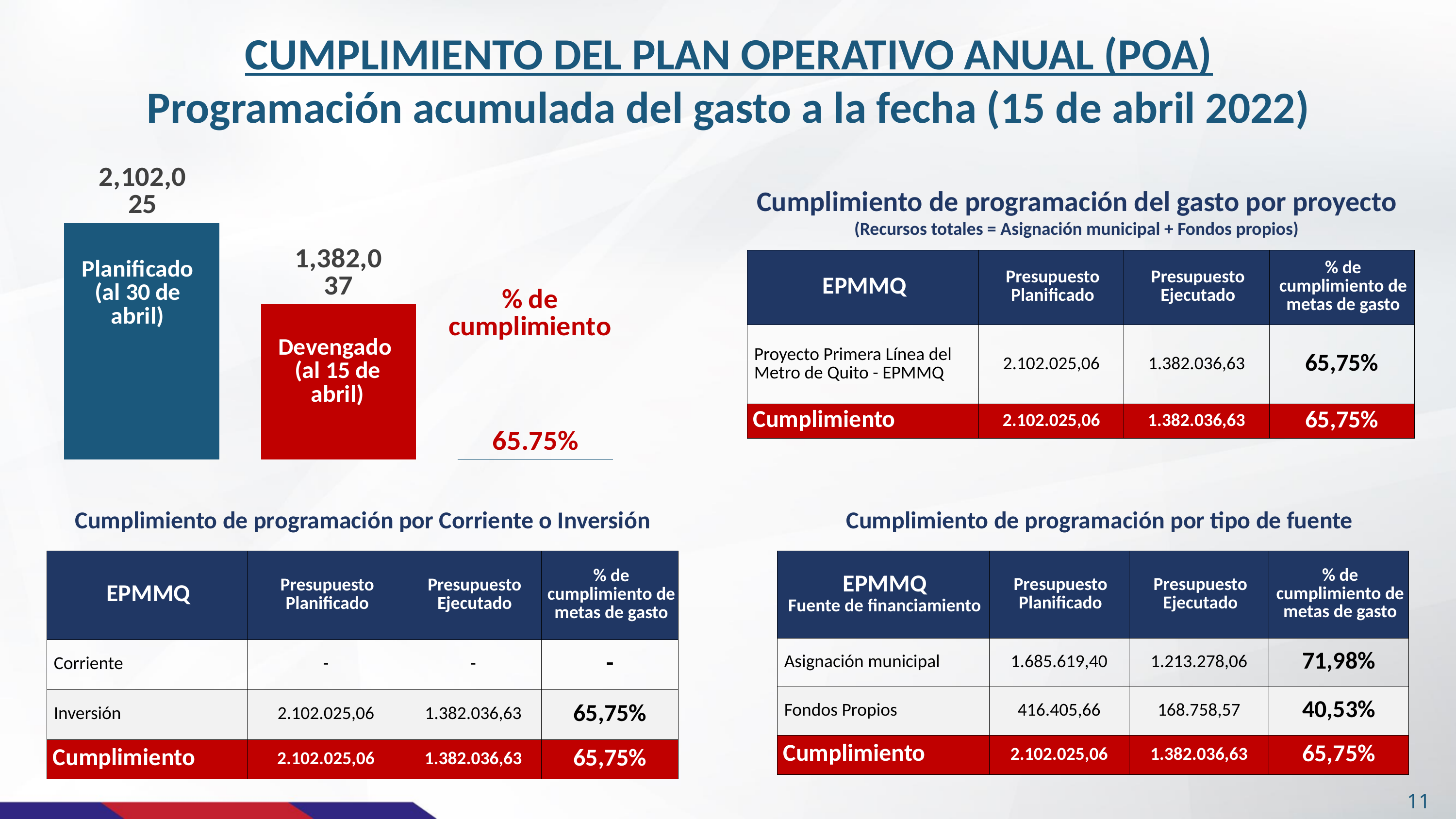
In the bar chart, do the values rise or fall from the left bar to the right bar? fall What kind of chart is shown on the left of the slide? bar chart How many bars are plotted in the bar chart? 2 In the bar chart, what value is shown for the 'Planificado (al 30 de abril)' bar? 2,102,025 In the bar chart, what colour is the 'Devengado (al 15 de abril)' bar? red In the bar chart, what is the difference between the Planificado value and the Devengado value? 719,988 In the bar chart, which bar has the lowest value? Devengado (al 15 de abril) In the bar chart, what value is shown for the 'Devengado (al 15 de abril)' bar? 1,382,037 What '% de cumplimiento' value is displayed next to the bar chart? 65.75% In the bar chart, which bar has the highest value? Planificado (al 30 de abril) In the bar chart, which is larger: the Planificado bar or the Devengado bar? Planificado